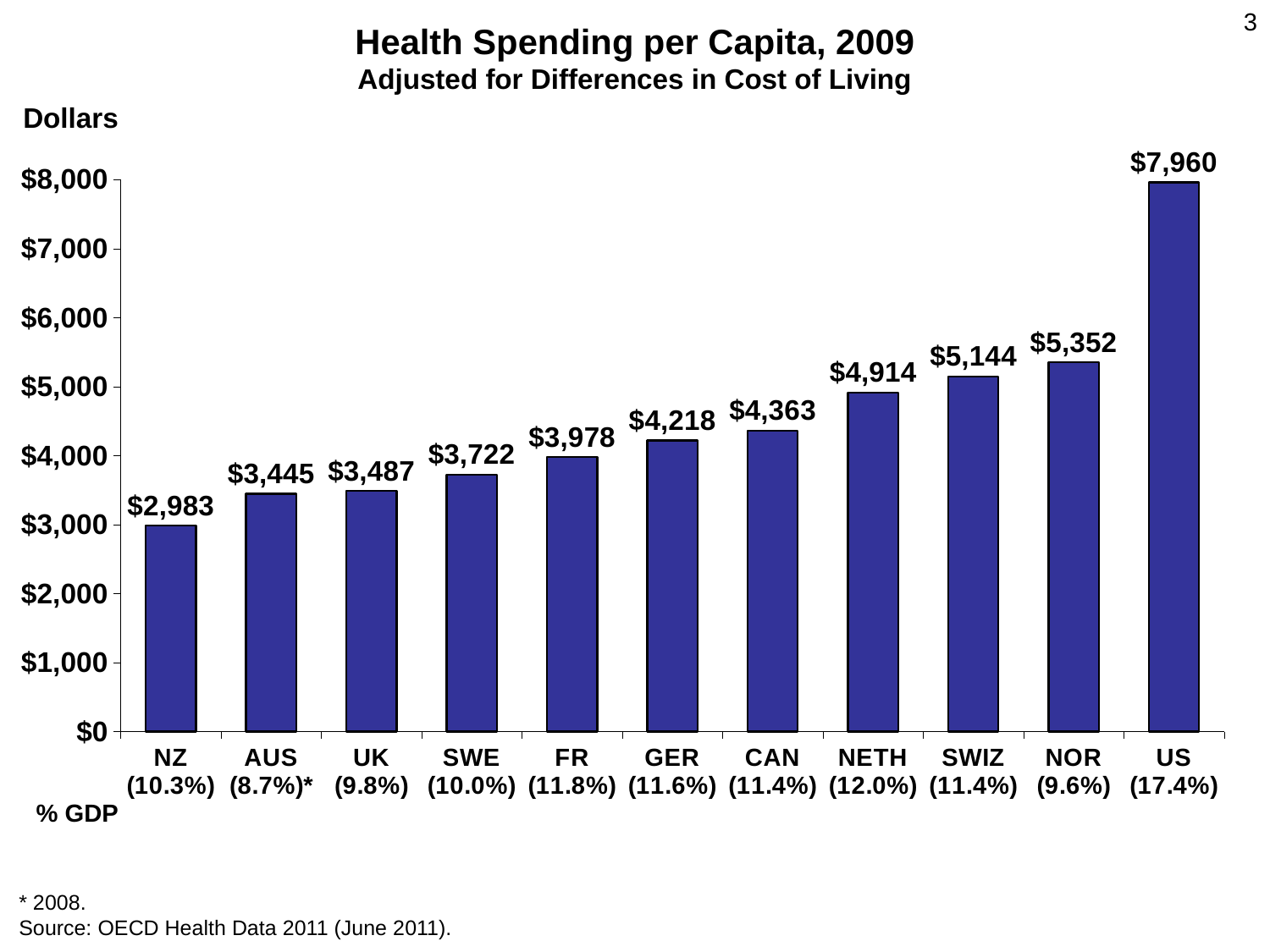
Which country has the highest health spending per capita? US What percentage of GDP is shown for the US below its bar label? 17.4% How many countries are shown in the chart? 11 What is the health spending per capita for the US? $7,960 Which country has the lowest health spending per capita? NZ Which has higher health spending per capita, Switzerland (SWIZ) or the Netherlands (NETH)? SWIZ What is the health spending per capita for Sweden (SWE)? $3,722 What is the difference in health spending per capita between the US and Norway (NOR)? $2,608 What is the difference in health spending per capita between Canada (CAN) and the UK? $876 Is the value for France (FR) greater or less than $4,000? less What is the health spending per capita for Germany (GER)? $4,218 What kind of chart is shown on the slide? Bar chart